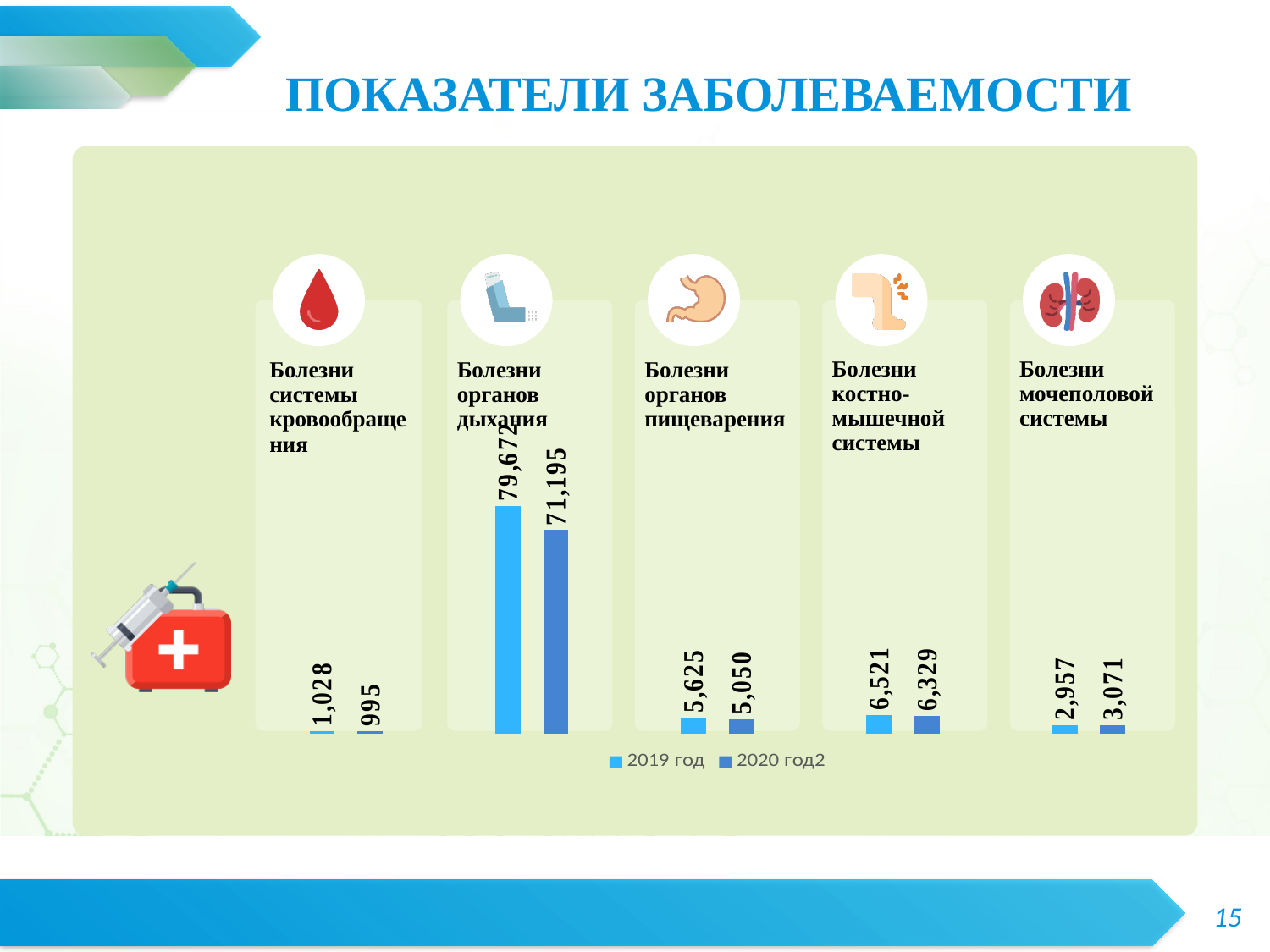
For Болезни мочеполовой системы, which is larger: the 2019 год value or the 2020 год2 value? 2020 год2 What is the value for Болезни мочеполовой системы in the 2020 год2 series? 3,071 What is the value for Болезни системы кровообращения in the 2019 год series? 1,028 What is the difference between the 2019 год and 2020 год2 values for Болезни органов дыхания? 8,477 What is the difference between the 2019 год and 2020 год2 values for Болезни органов пищеварения? 575 How many disease categories are shown in the chart? 5 Which category has the highest value in the 2019 год series? Болезни органов дыхания How many series does the legend list? 2 What is the value for Болезни органов дыхания in the 2020 год2 series? 71,195 What kind of chart is shown on the slide? Bar chart Which category has the lowest value in the 2020 год2 series? Болезни системы кровообращения What is the value for Болезни органов дыхания in the 2019 год series? 79,672